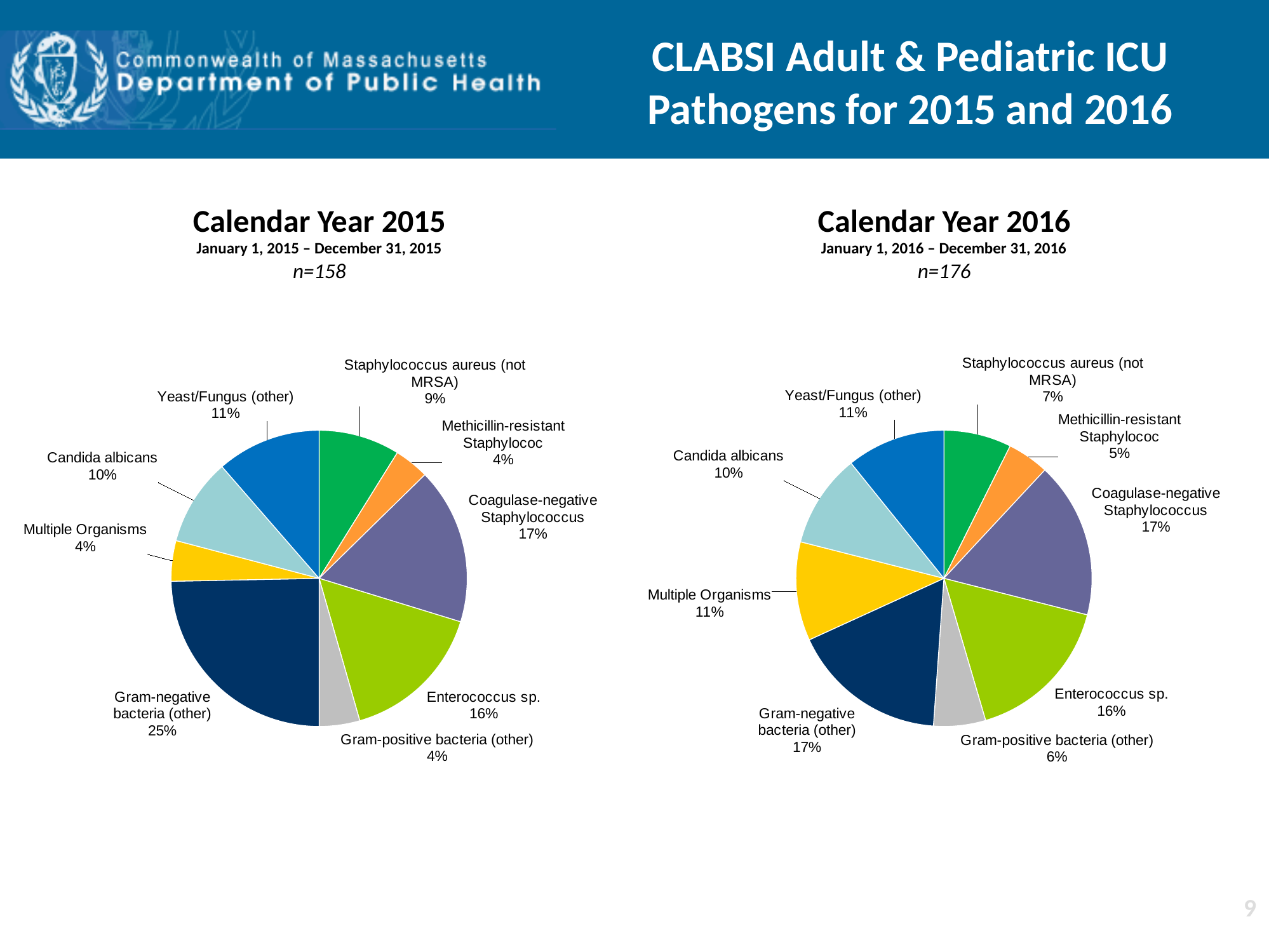
What is the difference between the Gram-negative bacteria (other) share in the Calendar Year 2015 chart and in the Calendar Year 2016 chart? 8% How many categories are shown in the Calendar Year 2015 pie chart? 9 What is the n value shown for the Calendar Year 2015 chart? n=158 In the Calendar Year 2015 pie chart, what share is Enterococcus sp.? 16% What is the n value shown for the Calendar Year 2016 chart? n=176 In the Calendar Year 2016 pie chart, what share is Multiple Organisms? 11% In the Calendar Year 2016 pie chart, what share is Staphylococcus aureus (not MRSA)? 7% What kind of chart is used for Calendar Year 2016? Pie chart In the Calendar Year 2015 pie chart, which category has the largest share? Gram-negative bacteria (other) In the Calendar Year 2015 pie chart, what share is Gram-negative bacteria (other)? 25% Which is larger in the Calendar Year 2016 pie chart: Coagulase-negative Staphylococcus or Candida albicans? Coagulase-negative Staphylococcus In the Calendar Year 2016 pie chart, what share is Gram-positive bacteria (other)? 6%